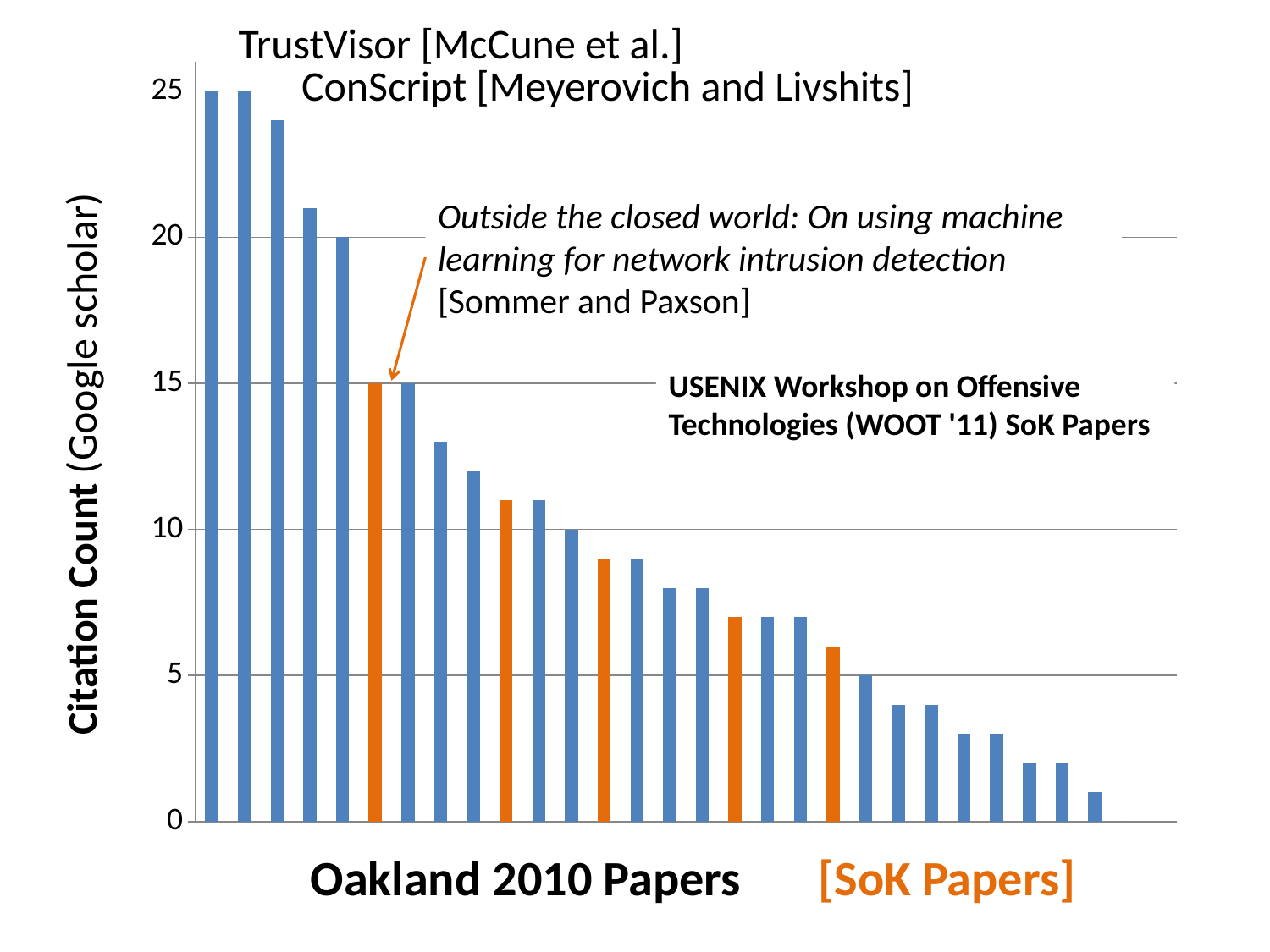
What do the orange bars represent according to the x-axis label? SoK Papers What is the label of the y axis? Citation Count (Google scholar) What is the citation count for the Sommer and Paxson paper ("Outside the closed world")? 15 Do the citation counts rise or fall moving from left to right along the x axis? fall Is the citation count of the rightmost (last) bar greater or less than 5? less Which has more citations: the Sommer and Paxson paper or the TrustVisor paper? TrustVisor What is the highest citation count shown on the chart? 25 What type of chart is shown on the slide? bar chart How many orange (SoK Papers) bars are on the chart? 5 Is the citation count of the third bar from the left greater or less than 20? greater Is the citation count of the lowest orange (SoK) bar greater or less than 10? less